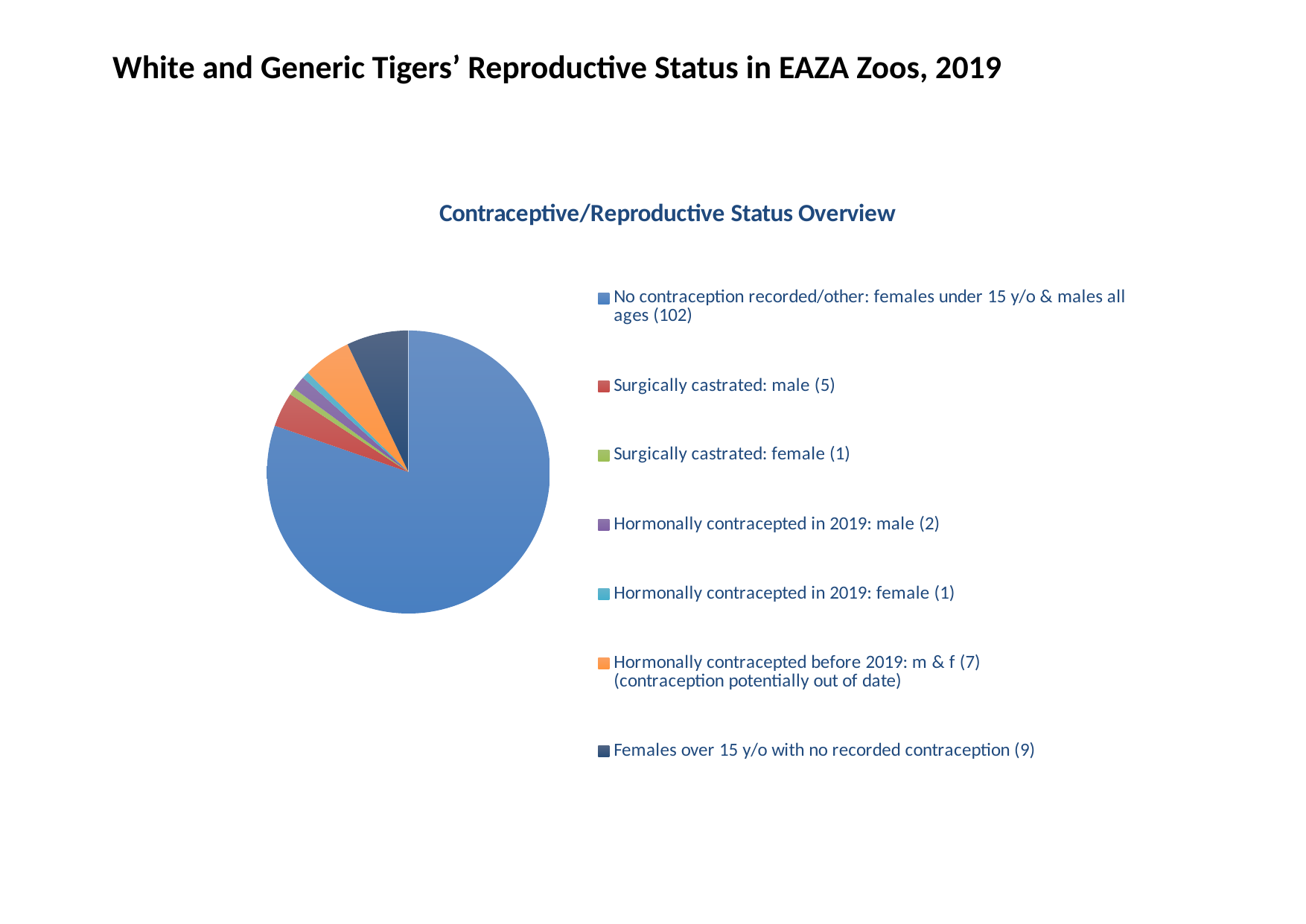
What is the difference between the 'No contraception recorded/other' count and the 'Females over 15 y/o with no recorded contraception' count? 93 How many tigers were hormonally contracepted before 2019 (m & f)? 7 Which is larger: 'Females over 15 y/o with no recorded contraception' or 'Hormonally contracepted before 2019: m & f'? Females over 15 y/o with no recorded contraception Which category has the largest slice of the pie? No contraception recorded/other: females under 15 y/o & males all ages What is the total number of tigers across all categories in the pie chart? 127 How many tigers are in the 'No contraception recorded/other: females under 15 y/o & males all ages' category? 102 What type of chart is shown on the slide? pie chart How many tigers are in the 'Surgically castrated: male' category? 5 How many categories does the pie chart have? 7 What is the title of the chart? Contraceptive/Reproductive Status Overview How many females over 15 y/o have no recorded contraception? 9 How many males were hormonally contracepted in 2019? 2